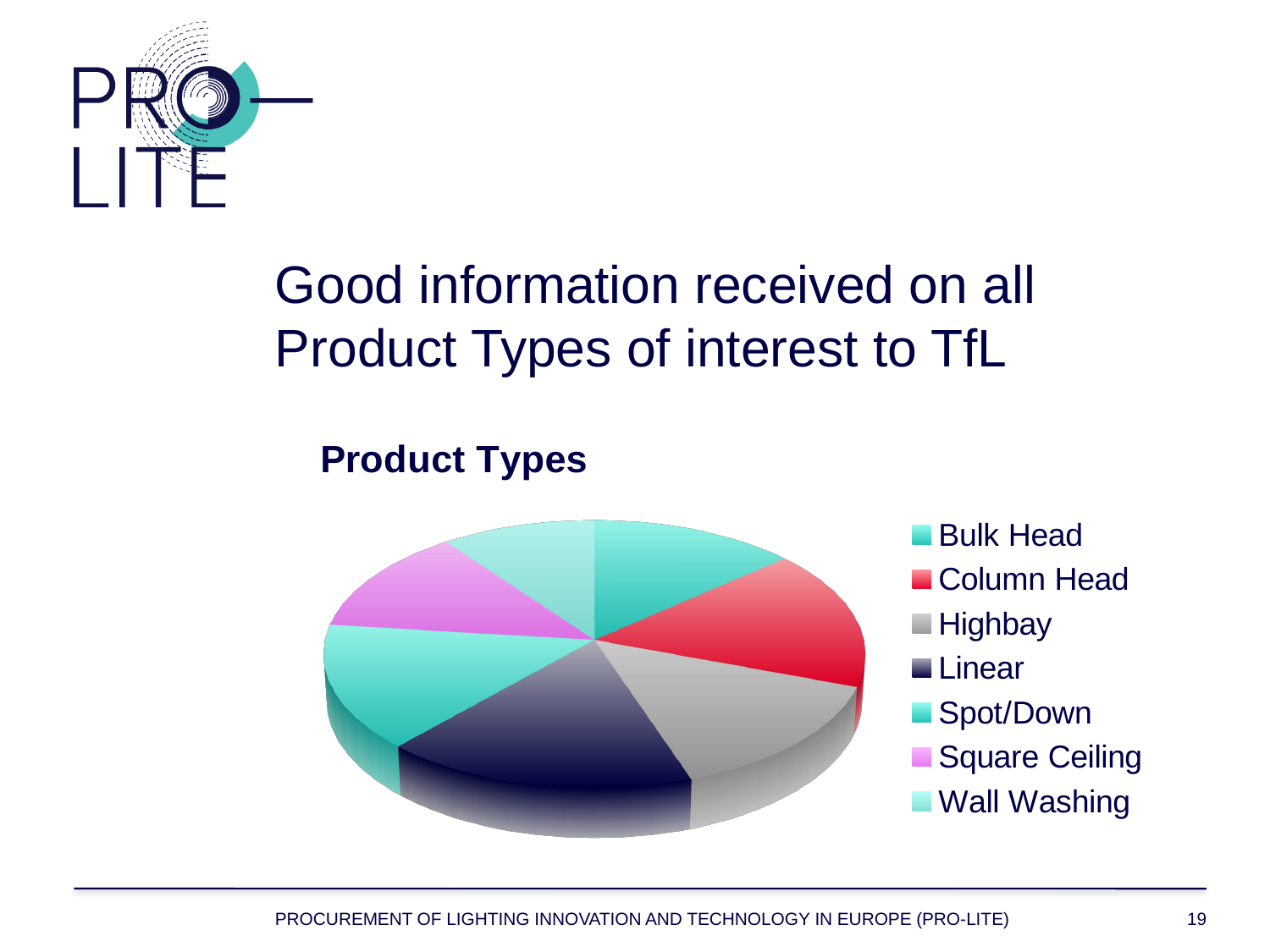
Which legend entry is listed last in the chart's legend? Wall Washing Which slice is larger, Linear or Wall Washing? Linear How many product types (slices) does the pie chart show? 7 What colour is the Column Head slice in the pie chart? red Which product type has the smallest slice of the pie? Wall Washing How many entries does the chart's legend list? 7 Which slice is larger, Highbay or Wall Washing? Highbay What is the title of the chart? Product Types What kind of chart is shown on the slide? pie chart